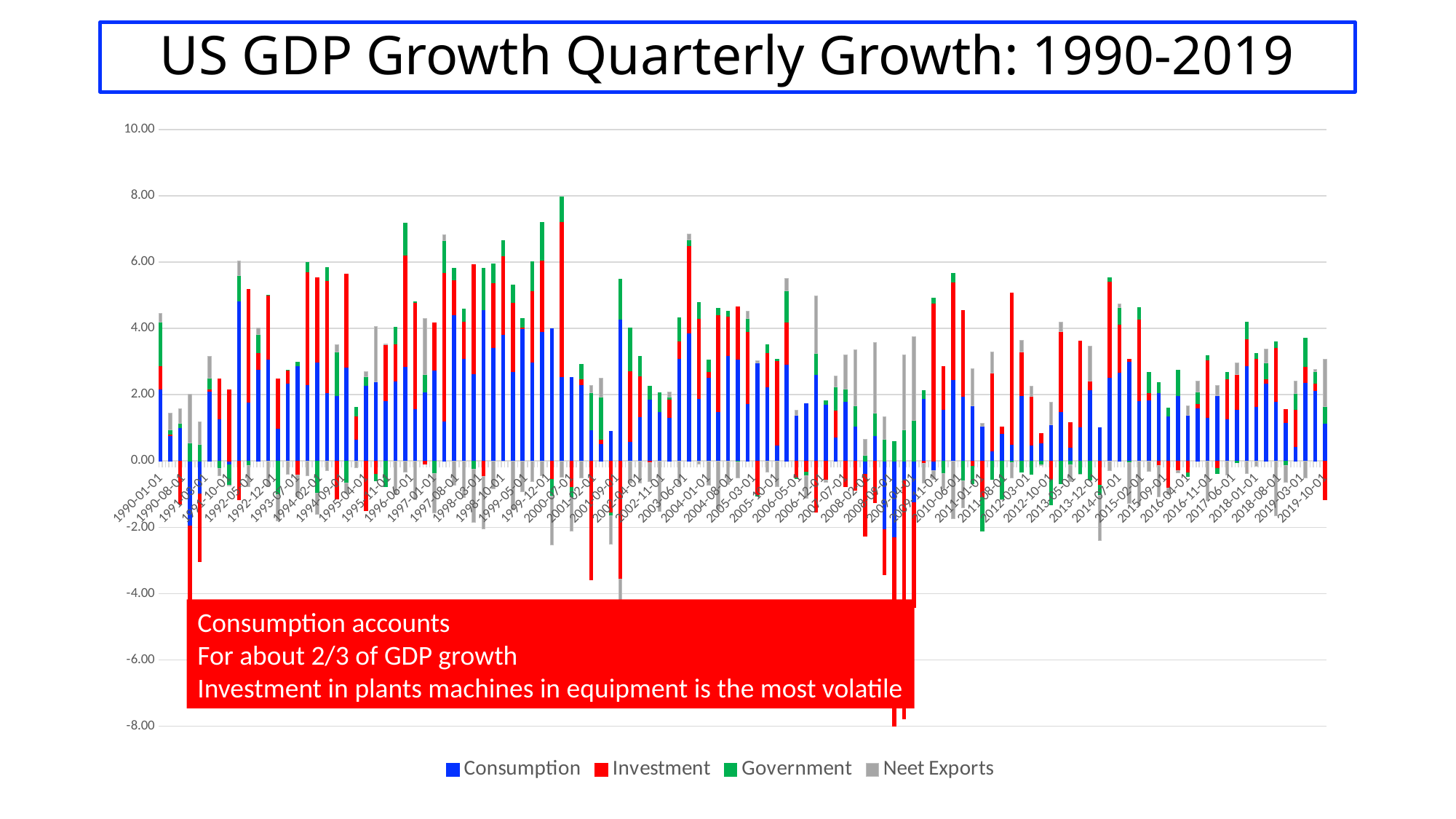
Is the total stacked value for 2000-07-01 greater or less than 6.00? less How many series does the legend list? 4 Is the Consumption value for 1990-01-01 greater or less than 4.00? less What is the title of the chart? US GDP Growth Quarterly Growth: 1990-2019 Which series is shown in grey in the legend? Neet Exports What kind of chart is shown on the slide? Stacked bar chart Is the Consumption value for 2000-07-01 greater or less than 2.00? greater